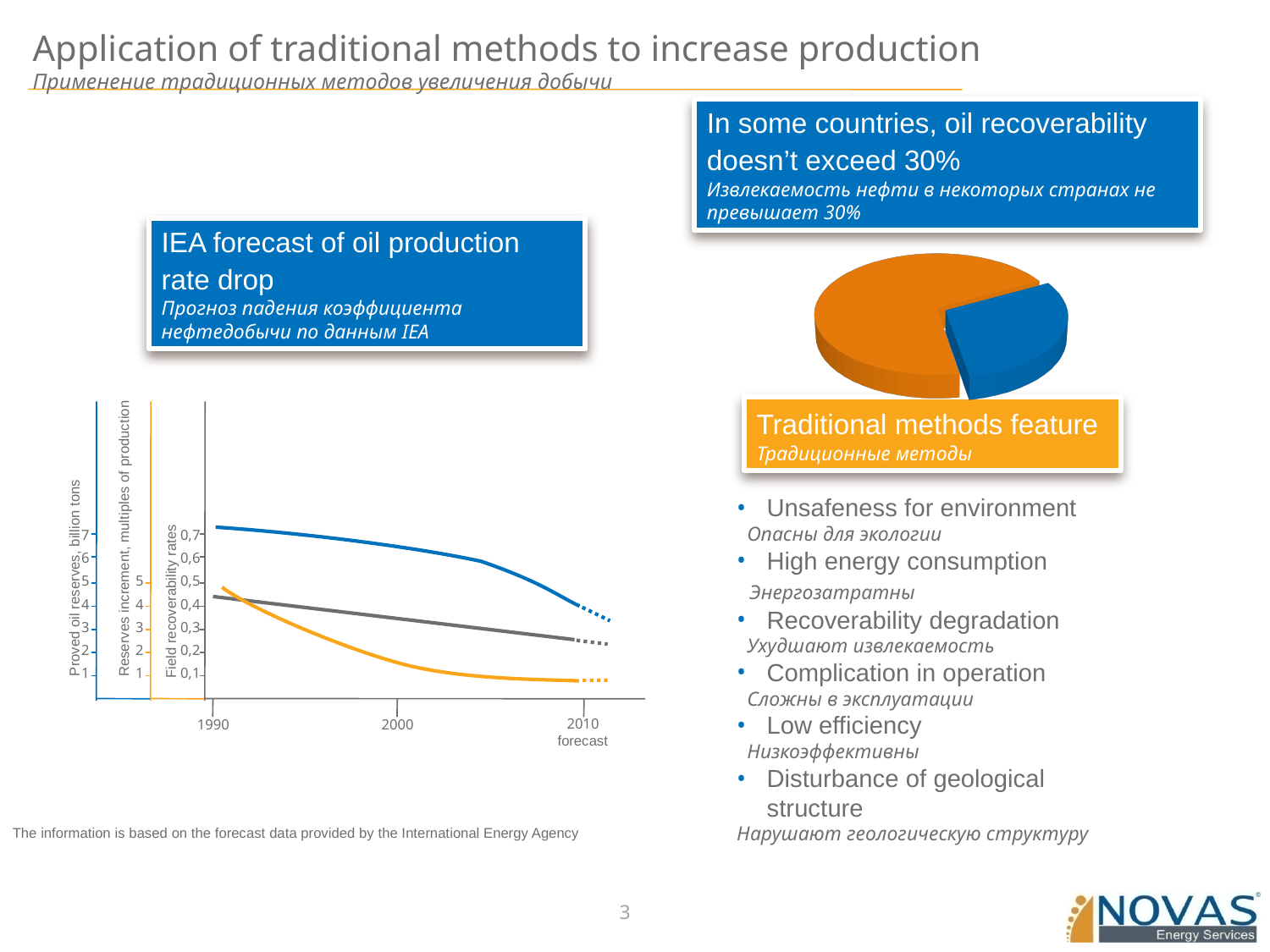
What is the label of the leftmost y axis on the 'IEA forecast of oil production rate drop' chart? Proved oil reserves, billion tons What type of chart is the 'IEA forecast of oil production rate drop' chart? line chart How many slices does the pie chart on the right side of the slide have? 2 On the 'IEA forecast of oil production rate drop' chart, which line is highest at 1990? the blue line On the 'IEA forecast of oil production rate drop' chart, do the lines rise or fall from 1990 to 2010? fall What type of chart is shown on the right side of the slide above 'Traditional methods feature'? pie chart How many year labels are shown on the x axis of the 'IEA forecast of oil production rate drop' chart? 3 In the pie chart on the right side of the slide, which slice is larger, the orange one or the blue one? the orange one How many lines are plotted on the 'IEA forecast of oil production rate drop' chart? 3 On the 'IEA forecast of oil production rate drop' chart, which is higher at 2010, the blue line or the grey line? the blue line On the 'IEA forecast of oil production rate drop' chart, which line is lowest at 2010? the orange line What word appears under the 2010 label on the x axis of the 'IEA forecast of oil production rate drop' chart? forecast